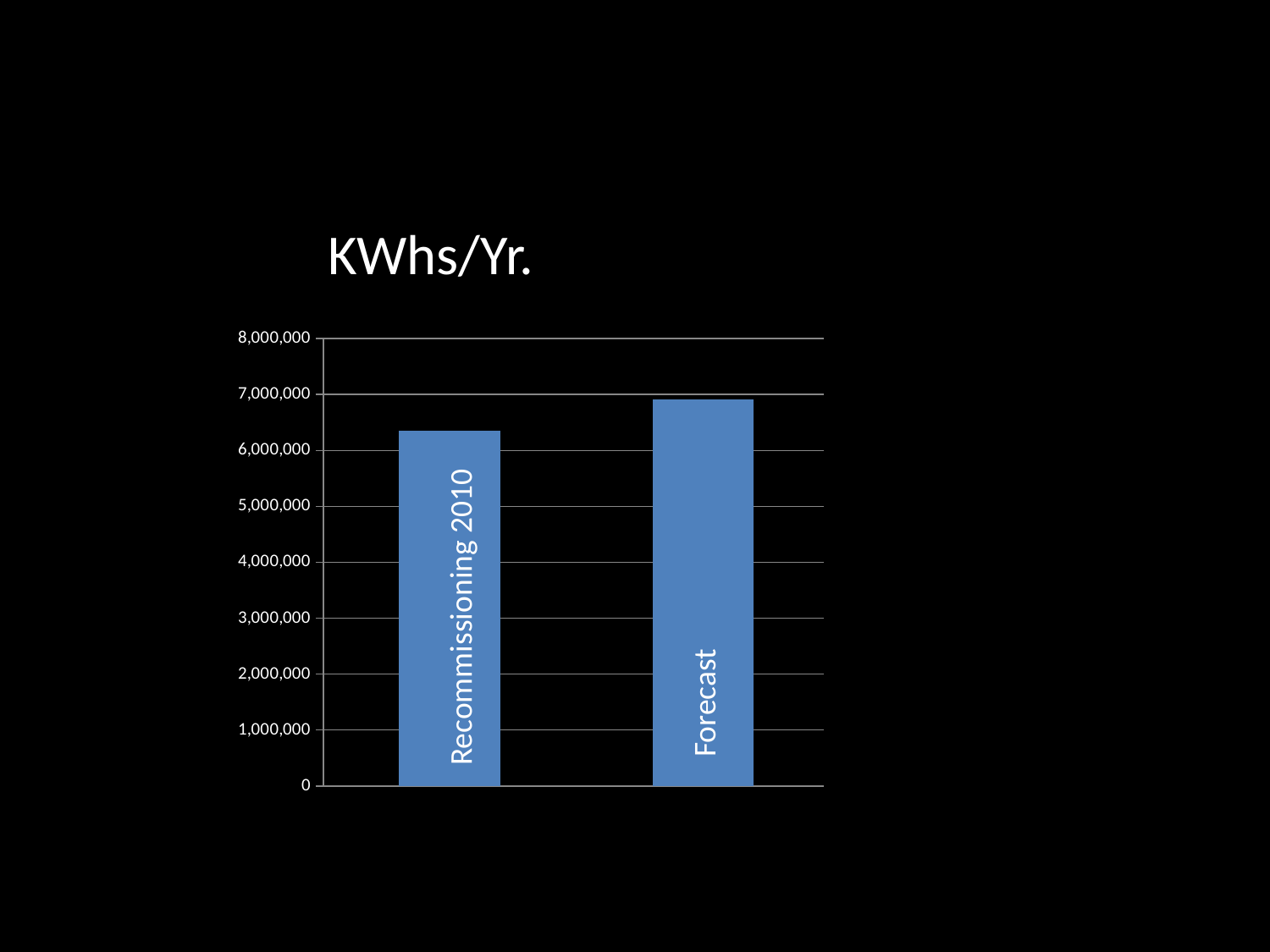
Do the values rise or fall from Recommissioning 2010 to Forecast? rise Is the value for Forecast greater or less than 7,000,000? less Which is larger, the value for Recommissioning 2010 or the value for Forecast? Forecast What is the maximum value shown on the vertical axis? 8,000,000 Is the value for Recommissioning 2010 greater or less than 7,000,000? less Which category has the highest value? Forecast Is the value for Recommissioning 2010 greater or less than 6,000,000? greater Which category has the lowest value? Recommissioning 2010 How many bars are plotted in the chart? 2 What type of chart is shown on the slide? bar chart What is the title of the chart? KWhs/Yr.